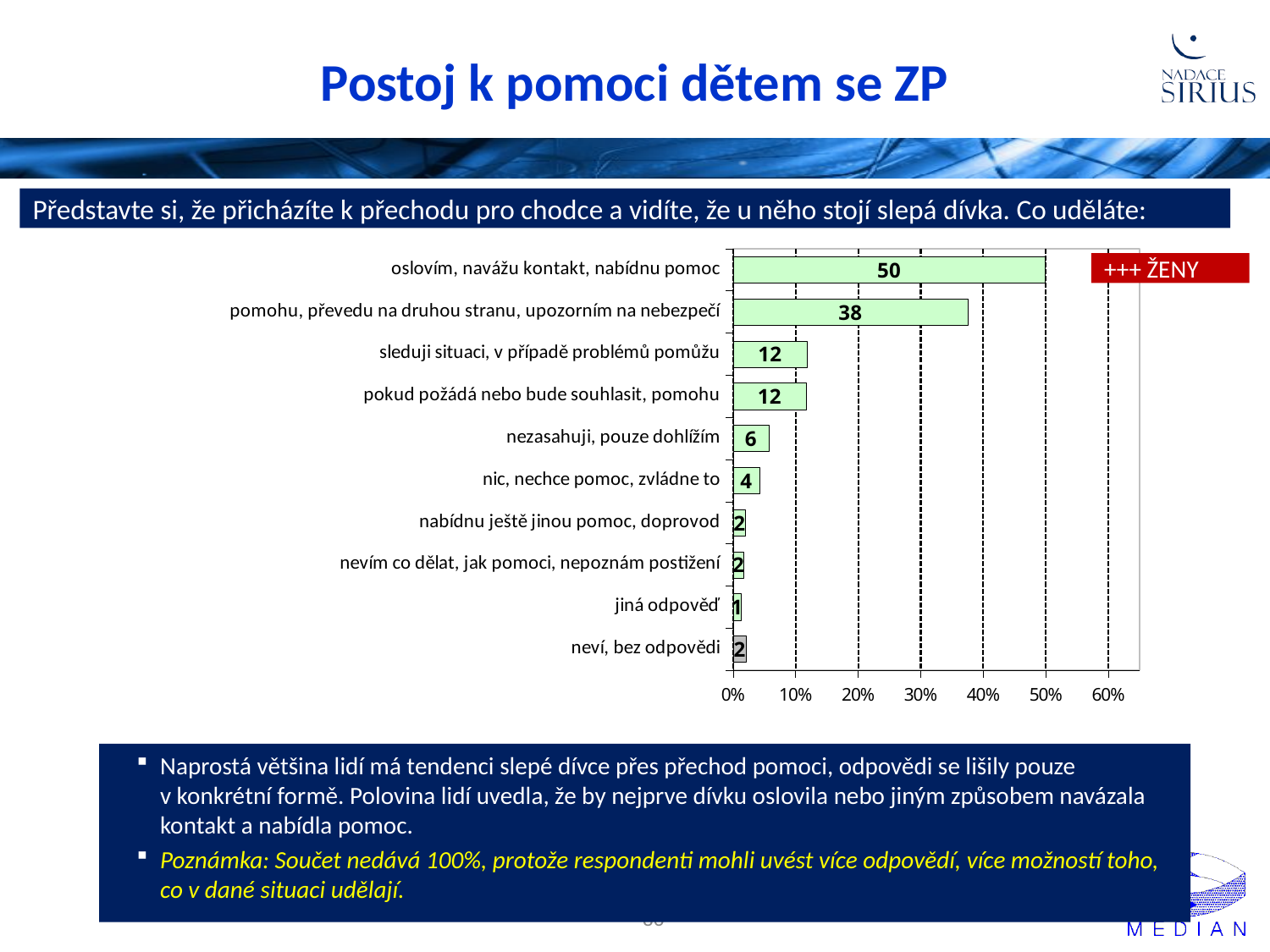
Which is larger, the value for "sleduji situaci, v případě problémů pomůžu" or the value for "nezasahuji, pouze dohlížím"? sleduji situaci, v případě problémů pomůžu Which category has the highest value? oslovím, navážu kontakt, nabídnu pomoc What is the value for "pomohu, převedu na druhou stranu, upozorním na nebezpečí"? 38 How many categories are shown in the chart? 10 Which category has the lowest value? jiná odpověď What is the value for "nezasahuji, pouze dohlížím"? 6 What is the difference between the values for "oslovím, navážu kontakt, nabídnu pomoc" and "pomohu, převedu na druhou stranu, upozorním na nebezpečí"? 12 What kind of chart is shown on the slide? bar chart Is the value for "pomohu, převedu na druhou stranu, upozorním na nebezpečí" greater or less than 30%? greater What is the highest value shown on the horizontal axis of the chart? 60% What is the value for "nic, nechce pomoc, zvládne to"? 4 What is the value for "oslovím, navážu kontakt, nabídnu pomoc"? 50